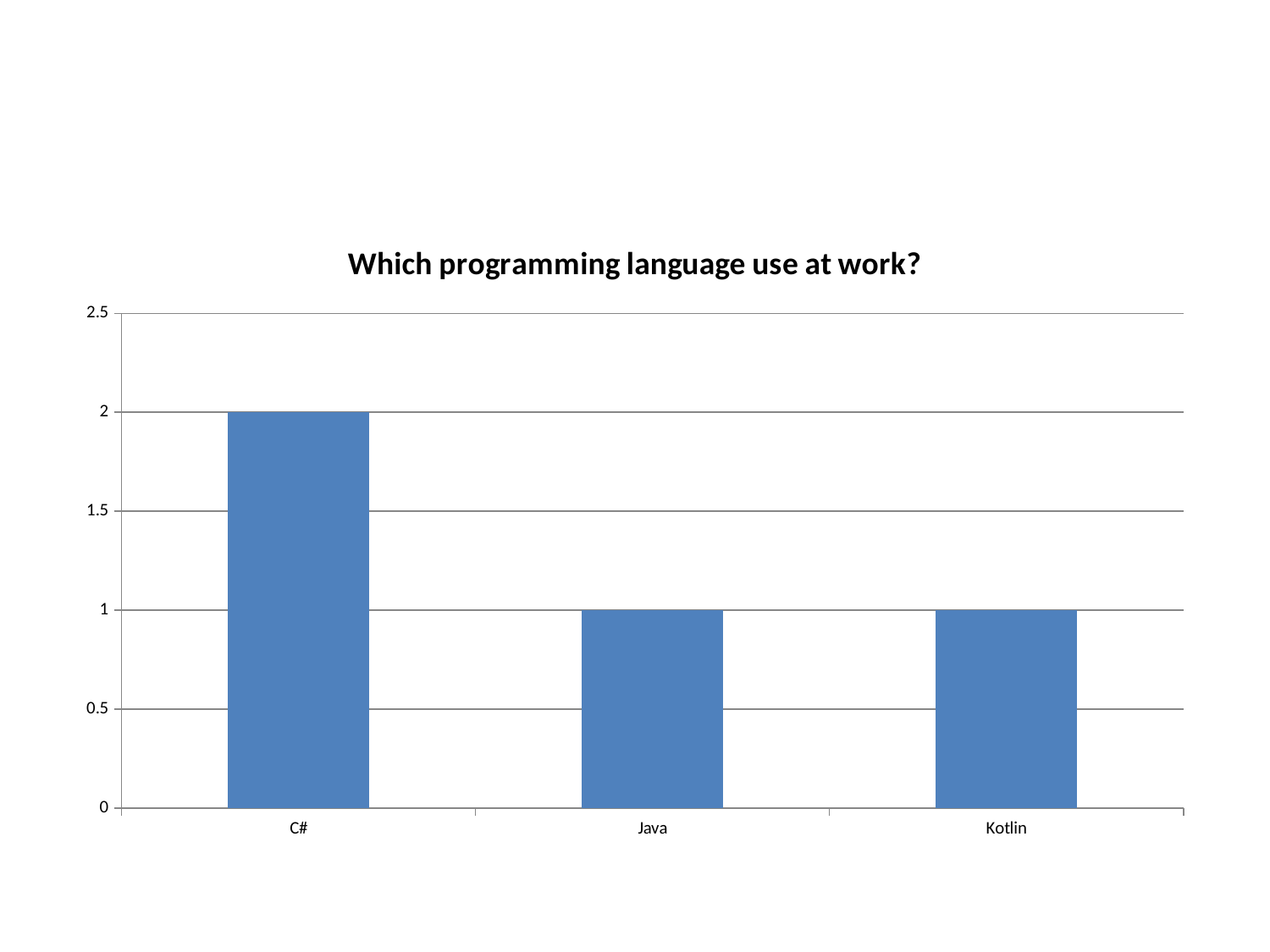
What is the value for Java? 1 Is the value for Java greater or less than 1.5? less What is the highest value shown on the y axis? 2.5 What is the difference between the values for C# and Java? 1 What is the value for C#? 2 What is the title of the chart? Which programming language use at work? What kind of chart is shown on the slide? bar chart Which programming language has the highest value? C# Is the value for C# greater or less than 1.5? greater What is the value for Kotlin? 1 Which is larger, the value for C# or the value for Kotlin? C# How many programming languages are shown on the x axis? 3